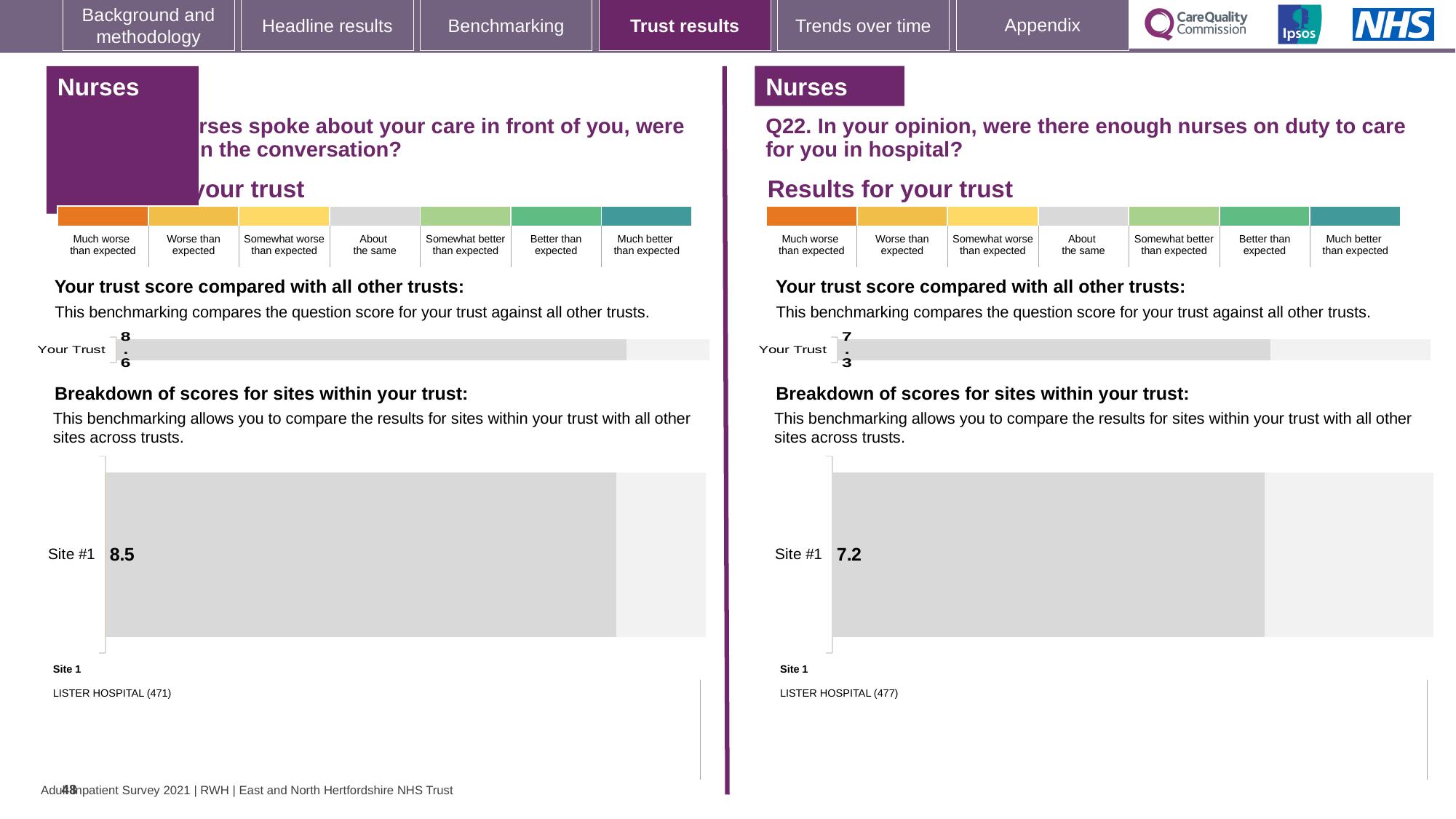
Which is larger: the Site #1 score on the left half of the slide or the Site #1 score on the right half (Q22)? Left half (8.5) On the right half of the slide (Q22), what score is shown for Site #1 in the site breakdown chart? 7.2 What is the question text shown above the charts on the right half of the slide? Q22. In your opinion, were there enough nurses on duty to care for you in hospital? Which hospital is listed as Site 1 beneath the site breakdown chart on the right half of the slide? LISTER HOSPITAL (477) How many sites are shown in the site breakdown chart on the left half of the slide? 1 What is the difference between the 'Your Trust' score on the left half of the slide (8.6) and the 'Your Trust' score on the right half (7.3)? 1.3 On the right half of the slide (Q22), what is the difference between the 'Your Trust' score and the Site #1 score? 0.1 On the right half of the slide (Q22), what is the 'Your Trust' score shown in the trust benchmarking bar chart? 7.3 On the left half of the slide, what score is shown for Site #1 in the site breakdown chart? 8.5 What type of chart is used to show the Site #1 score on the right half of the slide? bar chart On the left half of the slide, what is the 'Your Trust' score shown in the trust benchmarking bar chart? 8.6